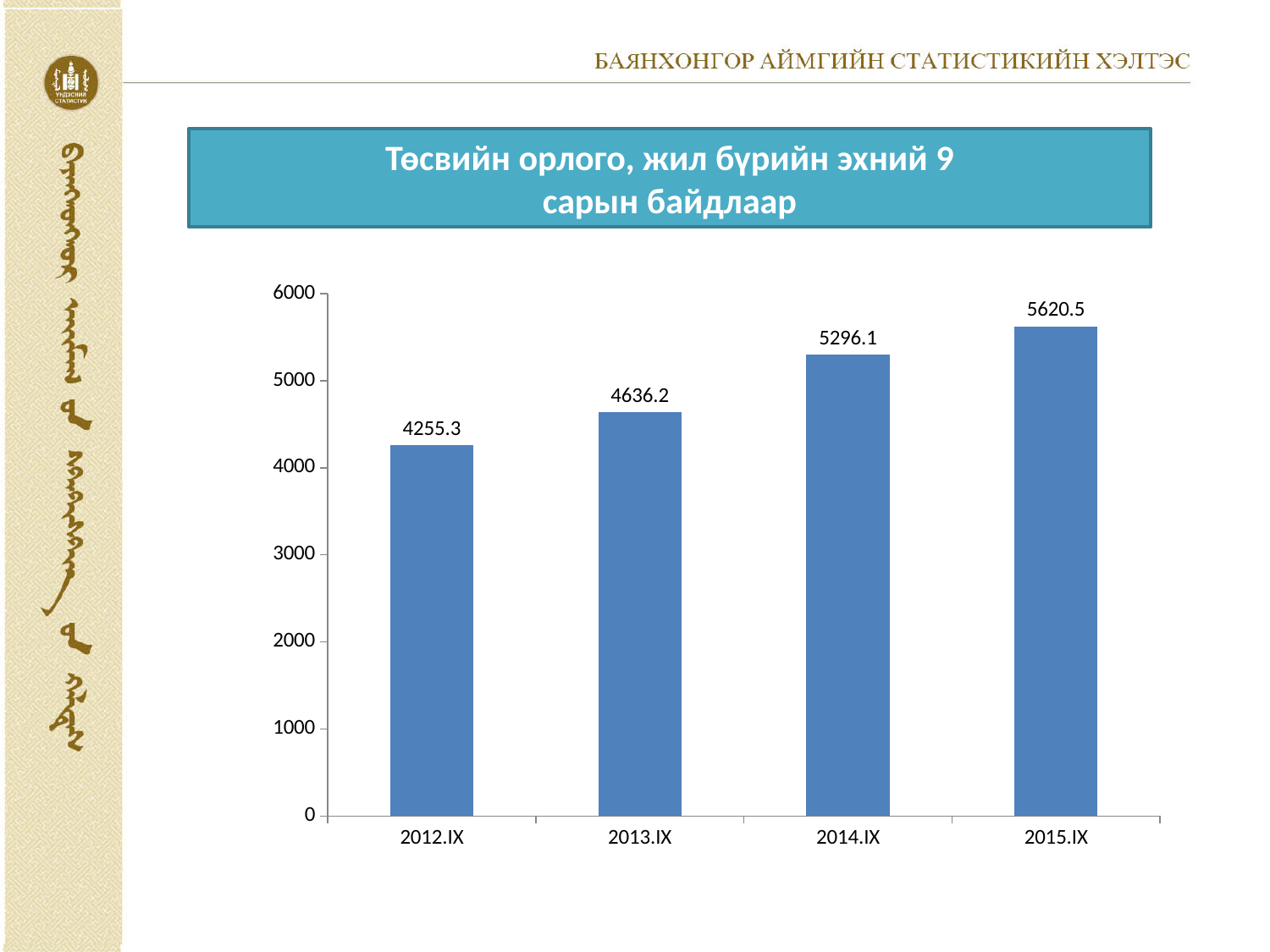
What kind of chart is shown on the slide? bar chart What is the difference between the values for 2014.IX and 2013.IX? 659.9 Is the value for 2013.IX greater or less than 5000? less What is the value for 2012.IX? 4255.3 What is the difference between the values for 2015.IX and 2012.IX? 1365.2 What is the value for 2014.IX? 5296.1 How many categories are shown on the x axis? 4 What is the value for 2013.IX? 4636.2 Which category has the highest value? 2015.IX What is the value for 2015.IX? 5620.5 Which category has the lowest value? 2012.IX Which is larger, the value for 2013.IX or the value for 2014.IX? 2014.IX